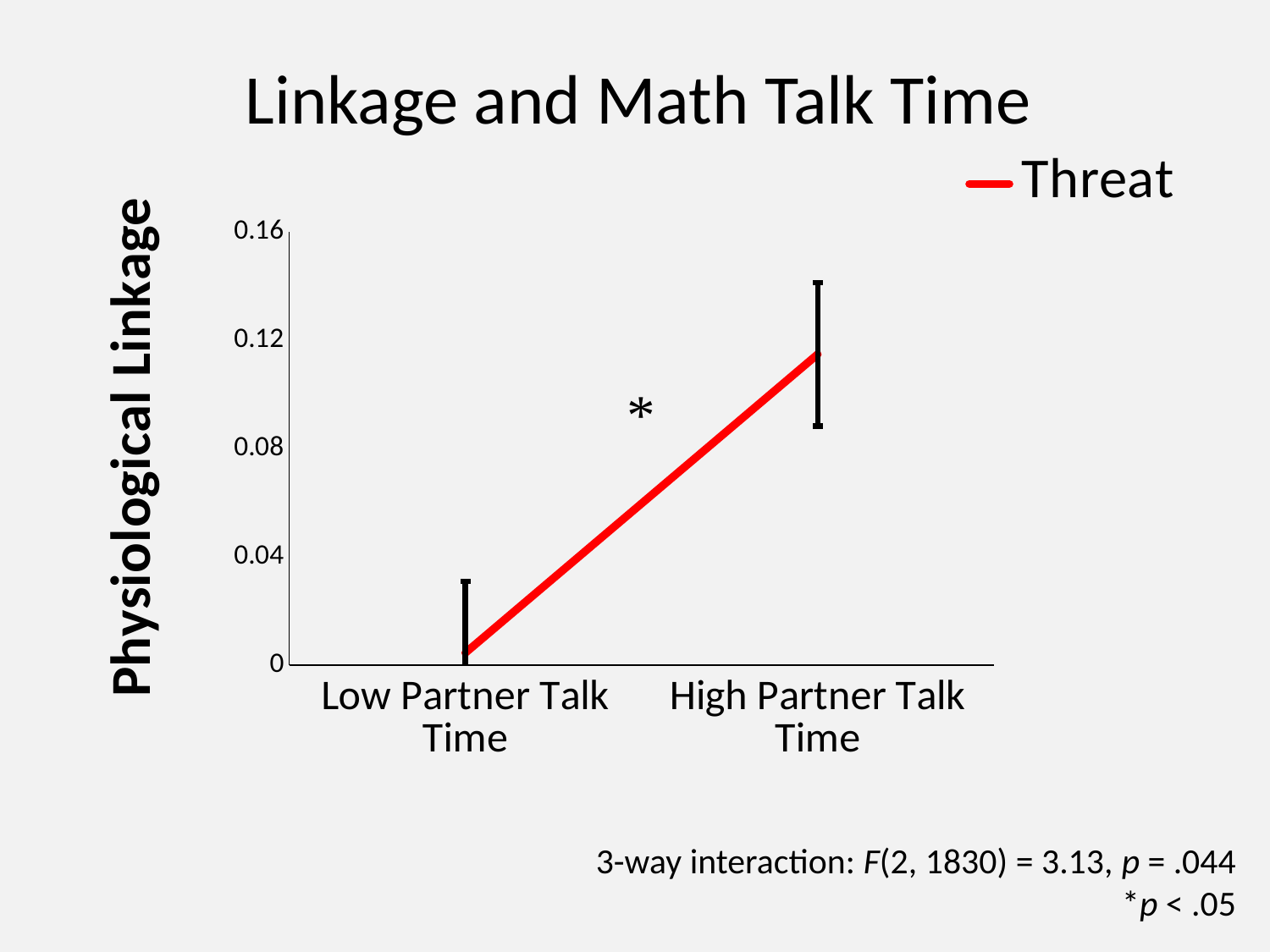
What is the label of the y axis? Physiological Linkage Is the Threat value for Low Partner Talk Time greater or less than 0.04? less Is the Threat value for High Partner Talk Time greater or less than 0.08? greater How many series does the legend list? 1 How many categories are shown on the x axis? 2 What kind of chart is shown on the slide? line chart Does the Threat line rise or fall from Low Partner Talk Time to High Partner Talk Time? rise Which category has the higher Physiological Linkage value for Threat? High Partner Talk Time What is the title of the chart? Linkage and Math Talk Time Is the Threat value larger for Low Partner Talk Time or High Partner Talk Time? High Partner Talk Time Which category has the lower Physiological Linkage value for Threat? Low Partner Talk Time